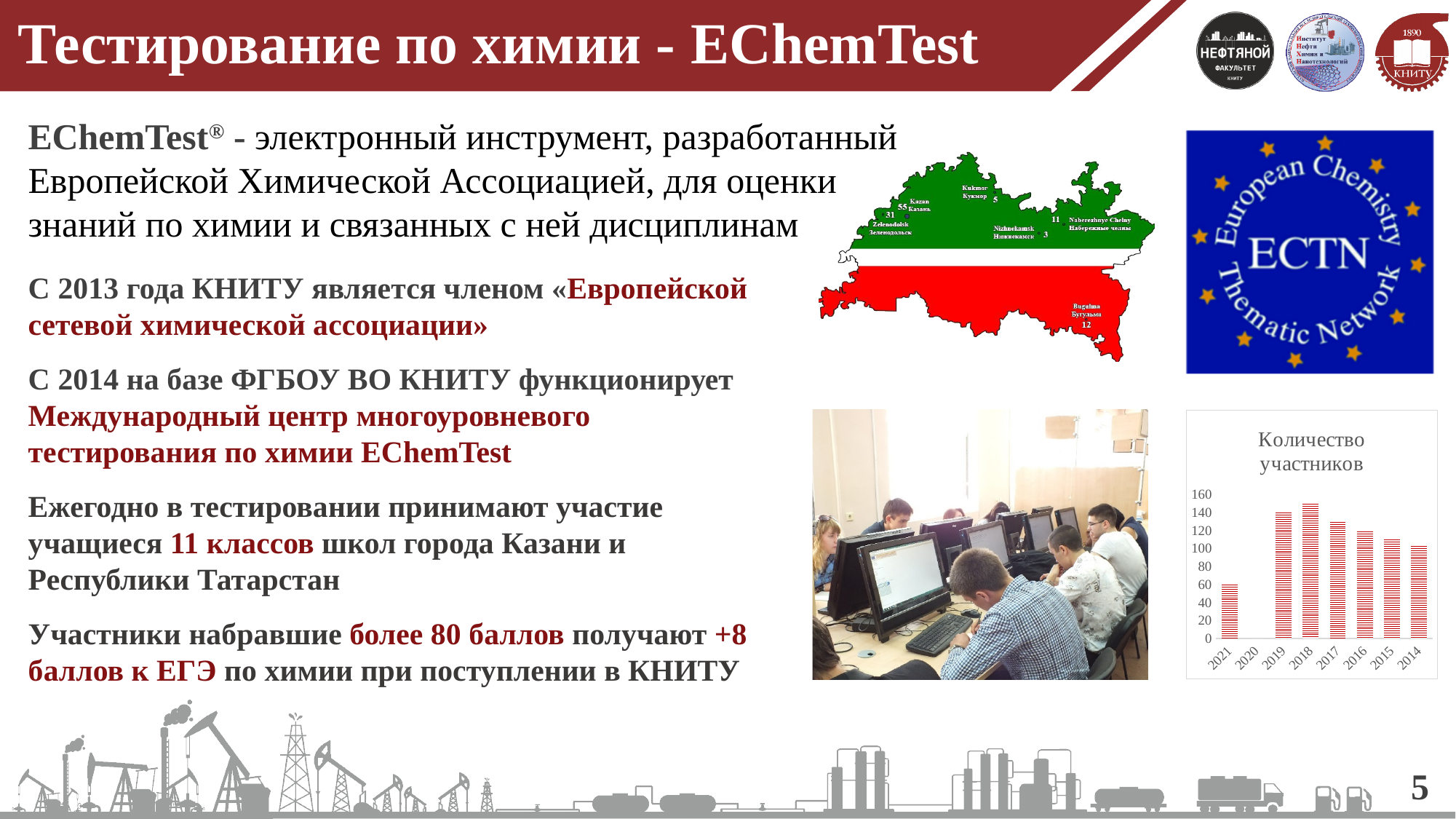
Is the value for 2014 greater or less than 120? less How many years are shown on the x axis of the chart? 8 Is the value for 2019 greater or less than 120? greater Which has the larger value, 2017 or 2016? 2017 Which year has the highest number of participants in the chart? 2018 Is the value for 2017 greater or less than 120? greater What is the title of the chart on the slide? Количество участников Which has the larger value, 2019 or 2021? 2019 What kind of chart is shown on the slide? bar chart